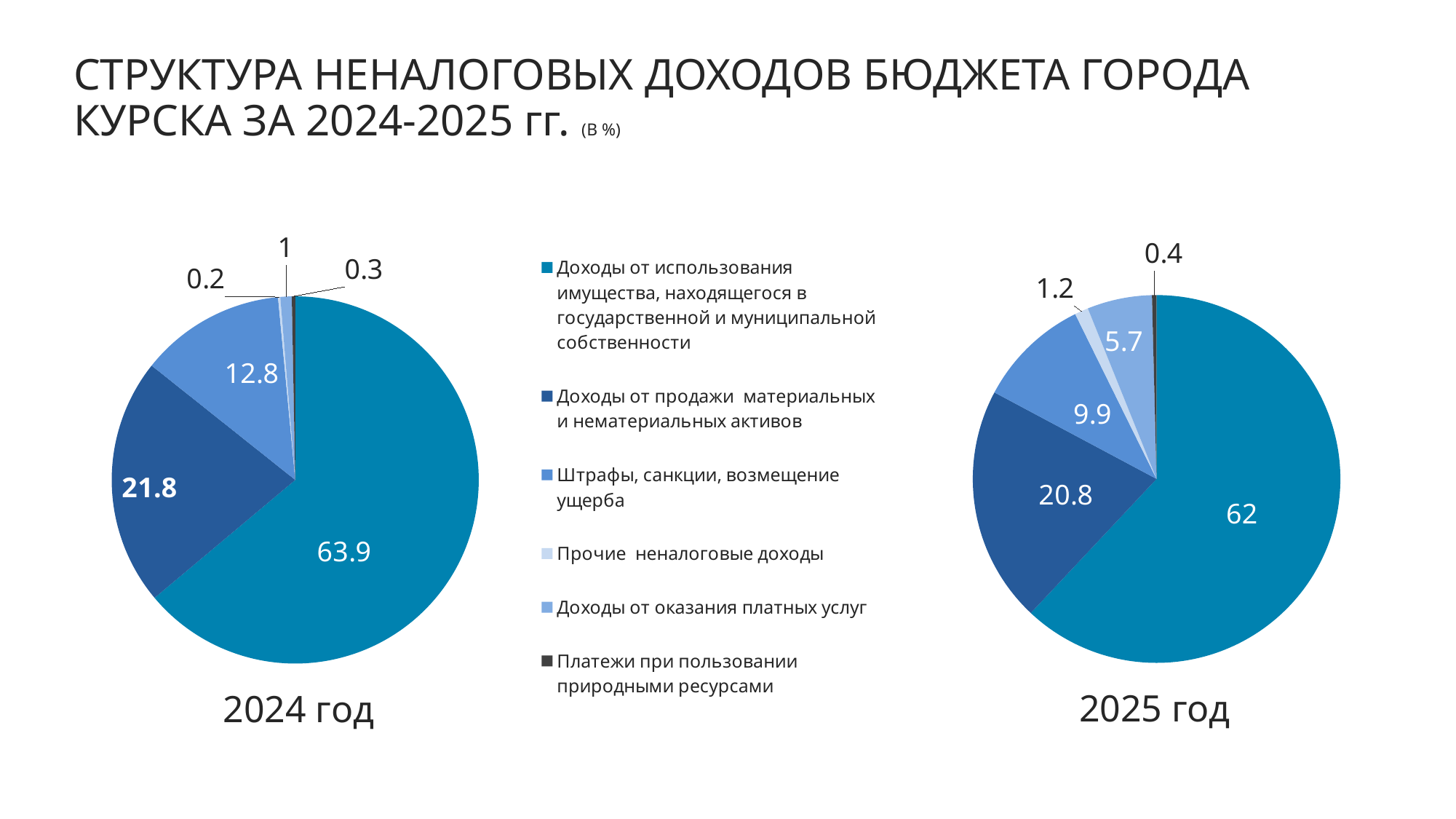
In the 2025 год pie chart, what is the share for Доходы от оказания платных услуг? 5.7 In the 2025 год pie chart, which category has the smallest share? Платежи при пользовании природными ресурсами Which is larger: the share of Штрафы, санкции, возмещение ущерба in the 2024 год chart or in the 2025 год chart? 2024 год In the 2025 год pie chart, what is the share for Доходы от продажи материальных и нематериальных активов? 20.8 In the 2025 год pie chart, what is the share for Штрафы, санкции, возмещение ущерба? 9.9 In the 2024 год pie chart, what is the share for Доходы от использования имущества, находящегося в государственной и муниципальной собственности? 63.9 What type of chart is used for the 2024 год and 2025 год data? Pie chart What is the difference between the share of Доходы от использования имущества in the 2024 год chart and in the 2025 год chart? 1.9 In the 2024 год pie chart, which category has the largest share? Доходы от использования имущества, находящегося в государственной и муниципальной собственности What is the title of the slide containing the two pie charts? СТРУКТУРА НЕНАЛОГОВЫХ ДОХОДОВ БЮДЖЕТА ГОРОДА КУРСКА ЗА 2024-2025 гг. (в %) How many categories does the legend list for the pie charts? 6 In the 2024 год pie chart, what is the share for Штрафы, санкции, возмещение ущерба? 12.8